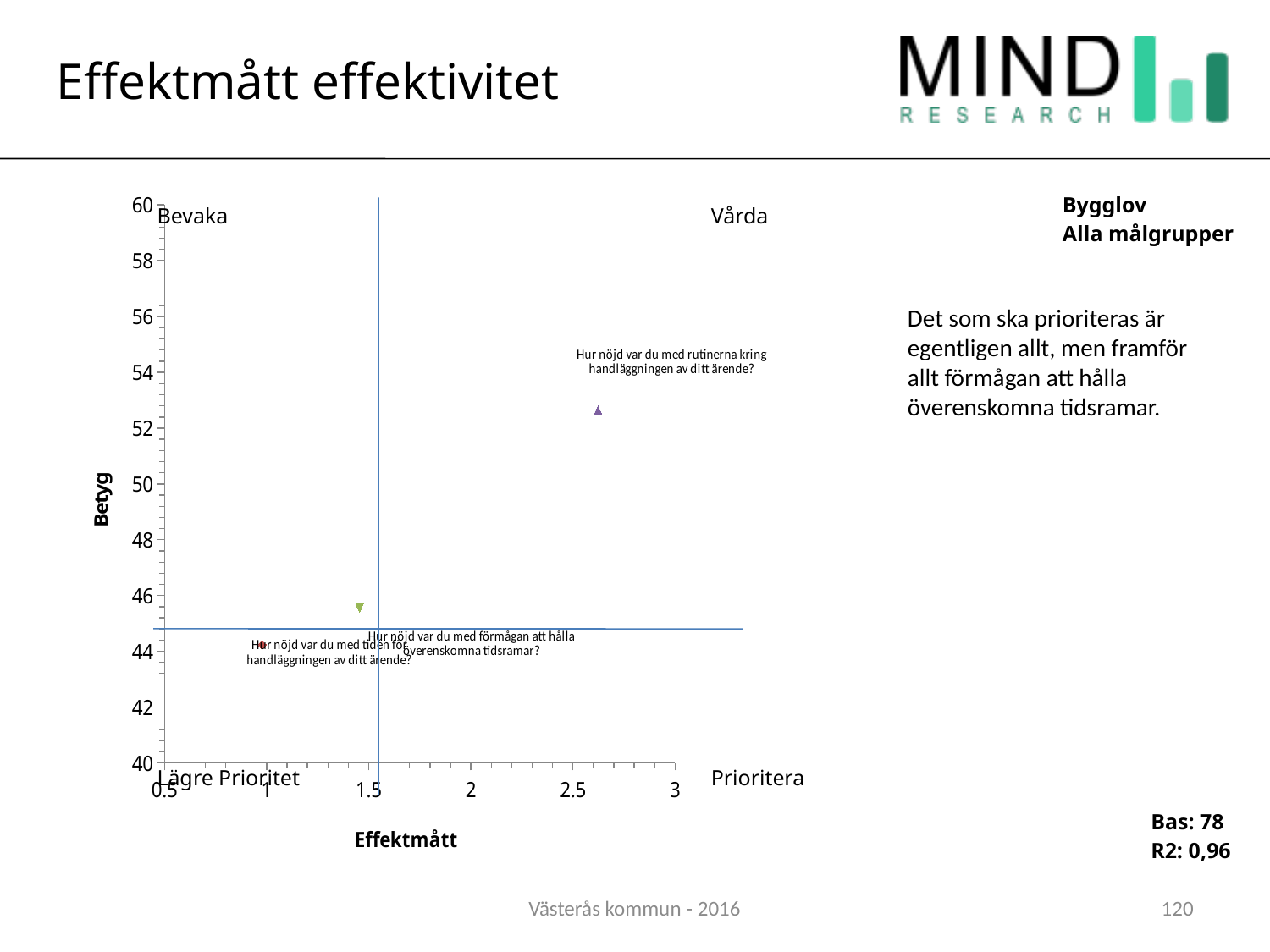
Is the Betyg value for 'Hur nöjd var du med rutinerna kring handläggningen av ditt ärende?' greater or less than 50? greater Which question has the lowest Betyg value in the chart? Hur nöjd var du med tiden för handläggningen av ditt ärende? Is the Effektmått value for 'Hur nöjd var du med tiden för handläggningen av ditt ärende?' greater or less than 1.5? less Is the Effektmått value for 'Hur nöjd var du med rutinerna kring handläggningen av ditt ärende?' greater or less than 2.5? greater Do the Betyg values rise or fall as Effektmått increases along the x axis? rise What kind of chart is shown on the slide? scatter plot How many data points are plotted in the chart? 3 What is the title of the x axis of the chart? Effektmått Which question has the highest Betyg value in the chart? Hur nöjd var du med rutinerna kring handläggningen av ditt ärende? Which has the higher Effektmått value: 'Hur nöjd var du med rutinerna kring handläggningen av ditt ärende?' or 'Hur nöjd var du med förmågan att hålla överenskomna tidsramar?' Hur nöjd var du med rutinerna kring handläggningen av ditt ärende? What is the title of the y axis of the chart? Betyg